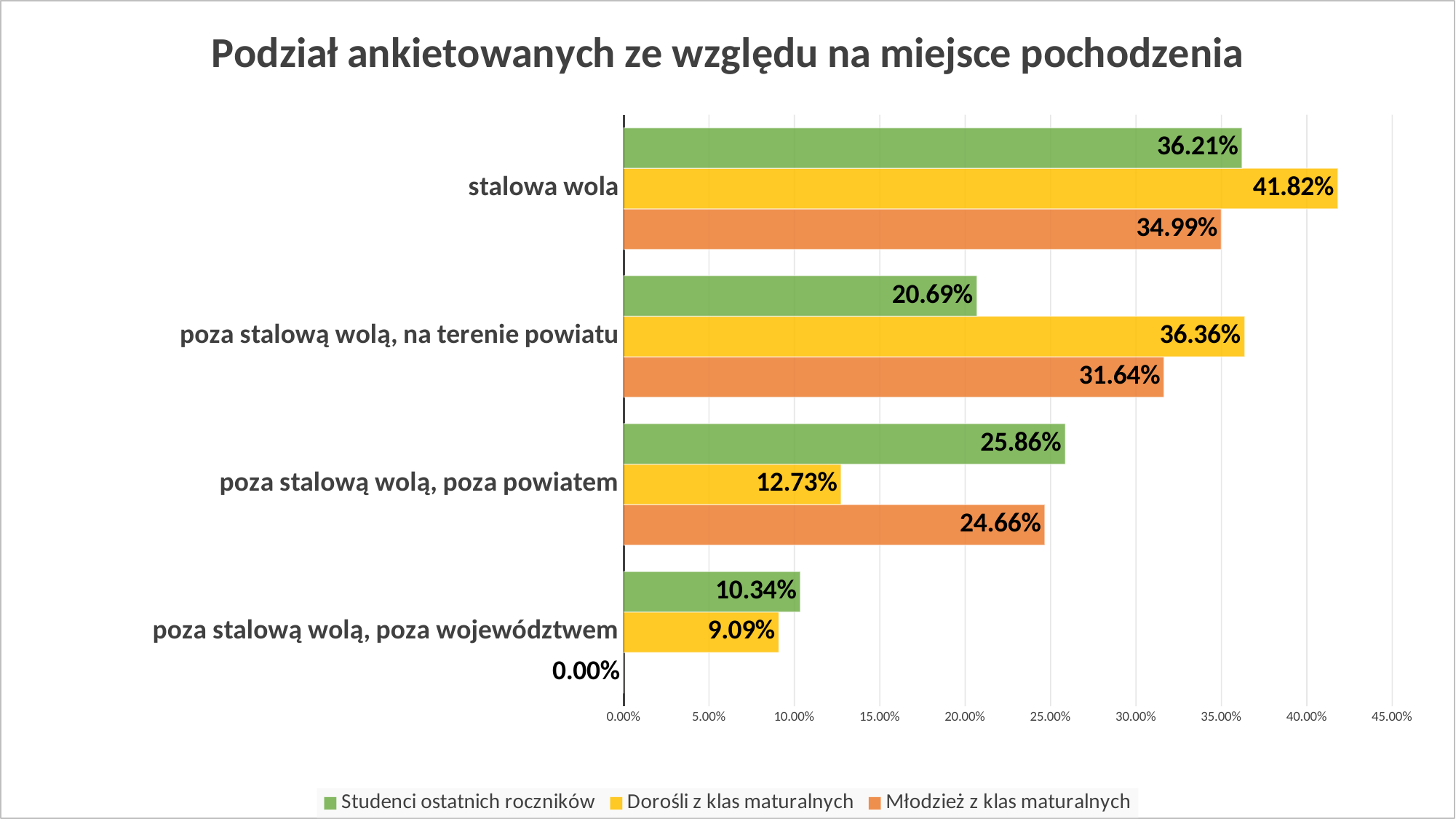
In the category poza stalową wolą, poza powiatem, which series has the larger value: Studenci ostatnich roczników or Dorośli z klas maturalnych? Studenci ostatnich roczników What kind of chart is shown on the slide? bar chart How many categories are shown on the y axis? 4 Which category has the highest value for Młodzież z klas maturalnych? stalowa wola Which category has the lowest value for Dorośli z klas maturalnych? poza stalową wolą, poza województwem Is the value for Młodzież z klas maturalnych in the category poza stalową wolą, na terenie powiatu greater or less than 30.00%? greater What is the value for Dorośli z klas maturalnych in the category stalowa wola? 41.82% How many series does the legend list? 3 What is the difference between the Dorośli z klas maturalnych and Studenci ostatnich roczników values for stalowa wola? 5.61% What is the value for Młodzież z klas maturalnych in the category poza stalową wolą, poza województwem? 0.00% What is the title of the chart? Podział ankietowanych ze względu na miejsce pochodzenia What is the value for Studenci ostatnich roczników in the category poza stalową wolą, na terenie powiatu? 20.69%